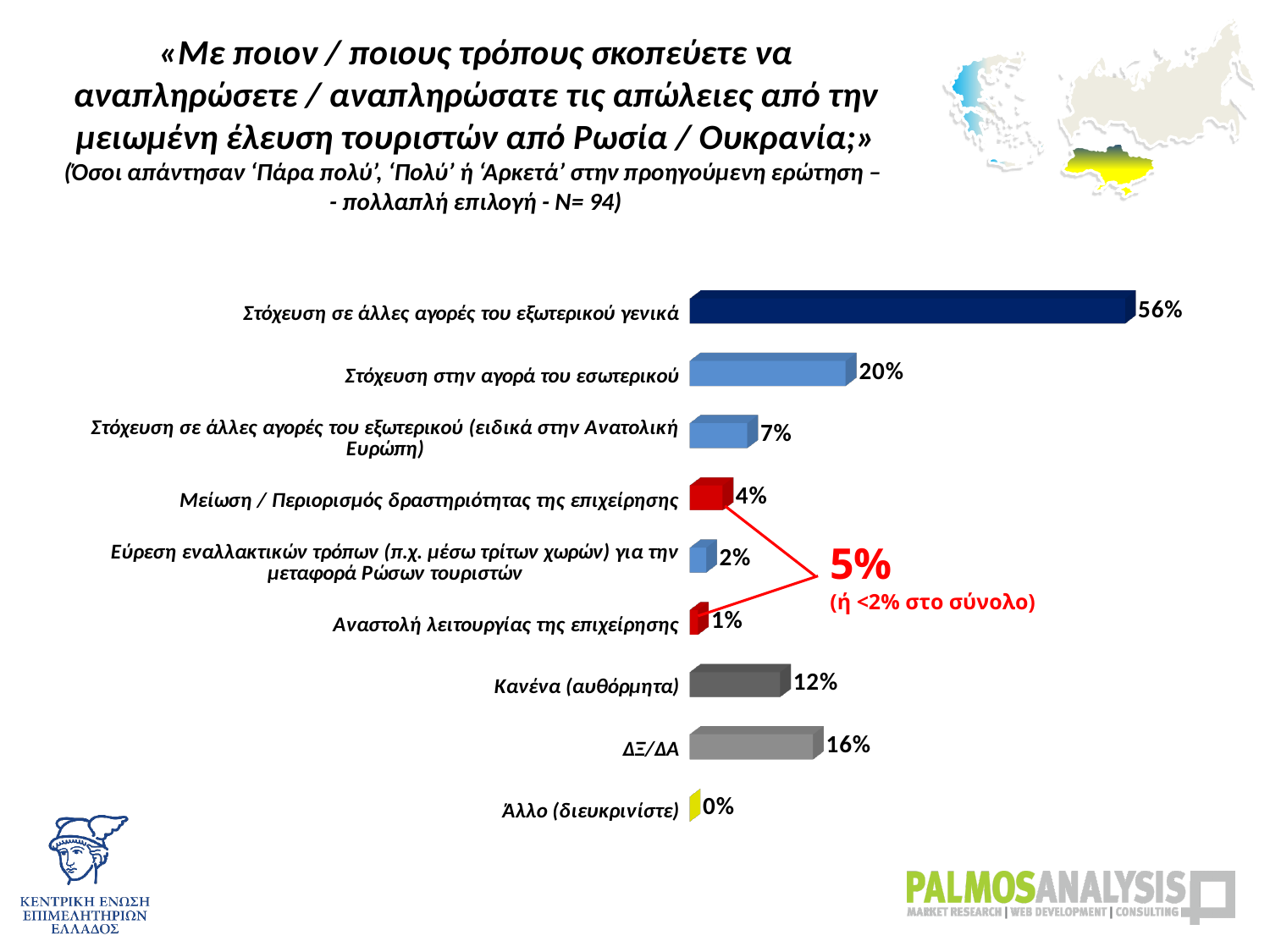
How many categories are shown in the chart? 9 What value is shown for «ΔΞ/ΔΑ»? 16% Which category has the highest value in the chart? Στόχευση σε άλλες αγορές του εξωτερικού γενικά What percentage is shown for «Στόχευση σε άλλες αγορές του εξωτερικού γενικά»? 56% Which category has the lowest value in the chart? Άλλο (διευκρινίστε) What value is shown for «Αναστολή λειτουργίας της επιχείρησης»? 1% What value is shown for «Κανένα (αυθόρμητα)»? 12% What combined percentage does the red annotation give for «Μείωση / Περιορισμός δραστηριότητας της επιχείρησης» and «Αναστολή λειτουργίας της επιχείρησης»? 5% Which is larger: the value for «ΔΞ/ΔΑ» or the value for «Κανένα (αυθόρμητα)»? ΔΞ/ΔΑ What is the difference between the values for «Στόχευση σε άλλες αγορές του εξωτερικού γενικά» and «Στόχευση στην αγορά του εσωτερικού»? 36% What kind of chart is shown on the slide? Bar chart What percentage is shown for «Στόχευση στην αγορά του εσωτερικού»? 20%